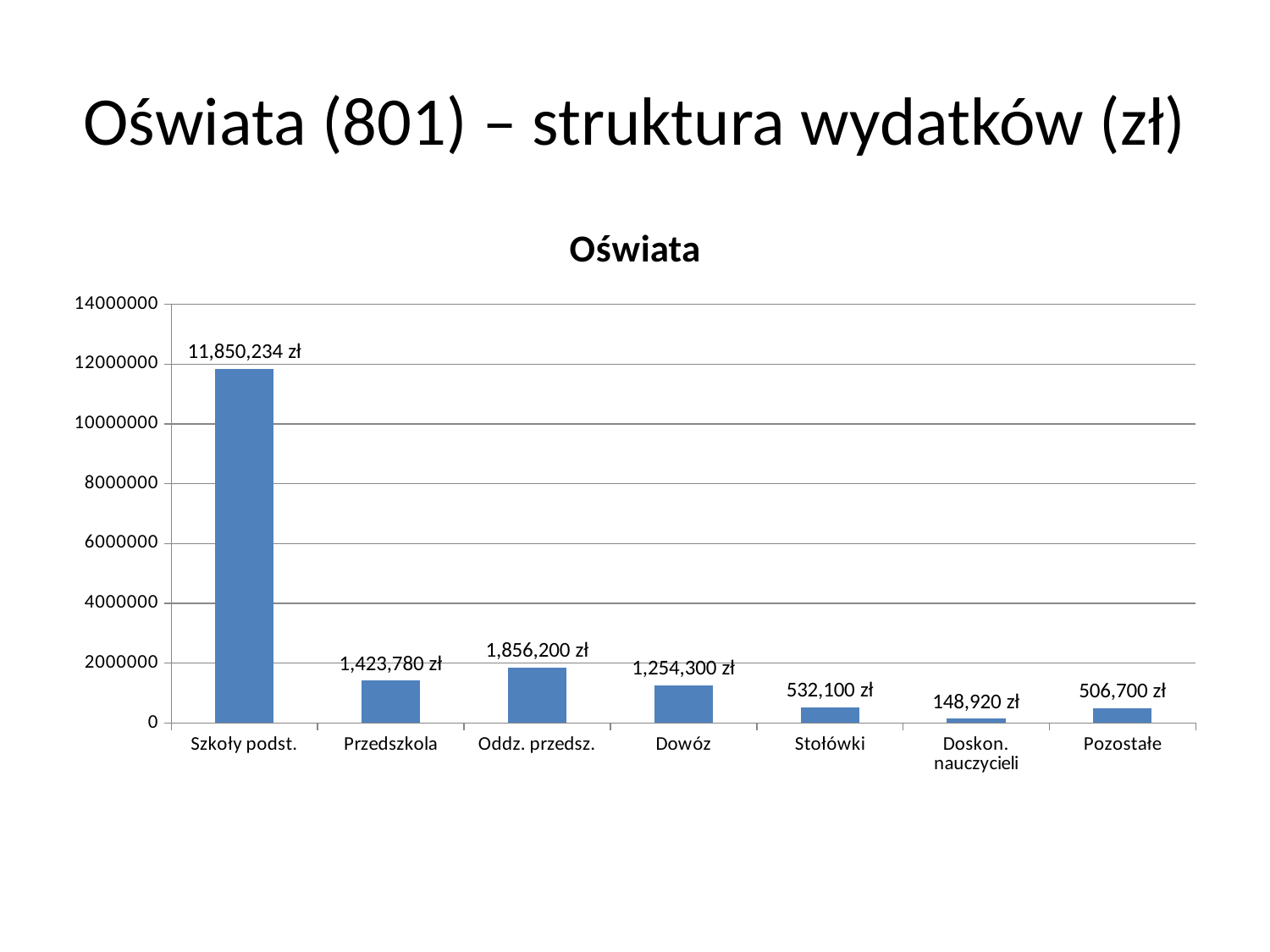
What is the value for Pozostałe? 506,700 zł What is the value for Oddz. przedsz.? 1,856,200 zł What is the difference between the values for Stołówki and Pozostałe? 25,400 zł Which category has the lowest value? Doskon. nauczycieli Which is larger, the value for Przedszkola or the value for Dowóz? Przedszkola What kind of chart is shown on the slide? Bar chart What is the value for Szkoły podst.? 11,850,234 zł What is the difference between the values for Oddz. przedsz. and Przedszkola? 432,420 zł How many categories are shown on the x axis? 7 What is the value for Doskon. nauczycieli? 148,920 zł Is the value for Szkoły podst. greater or less than 10000000? greater Which category has the highest value? Szkoły podst.